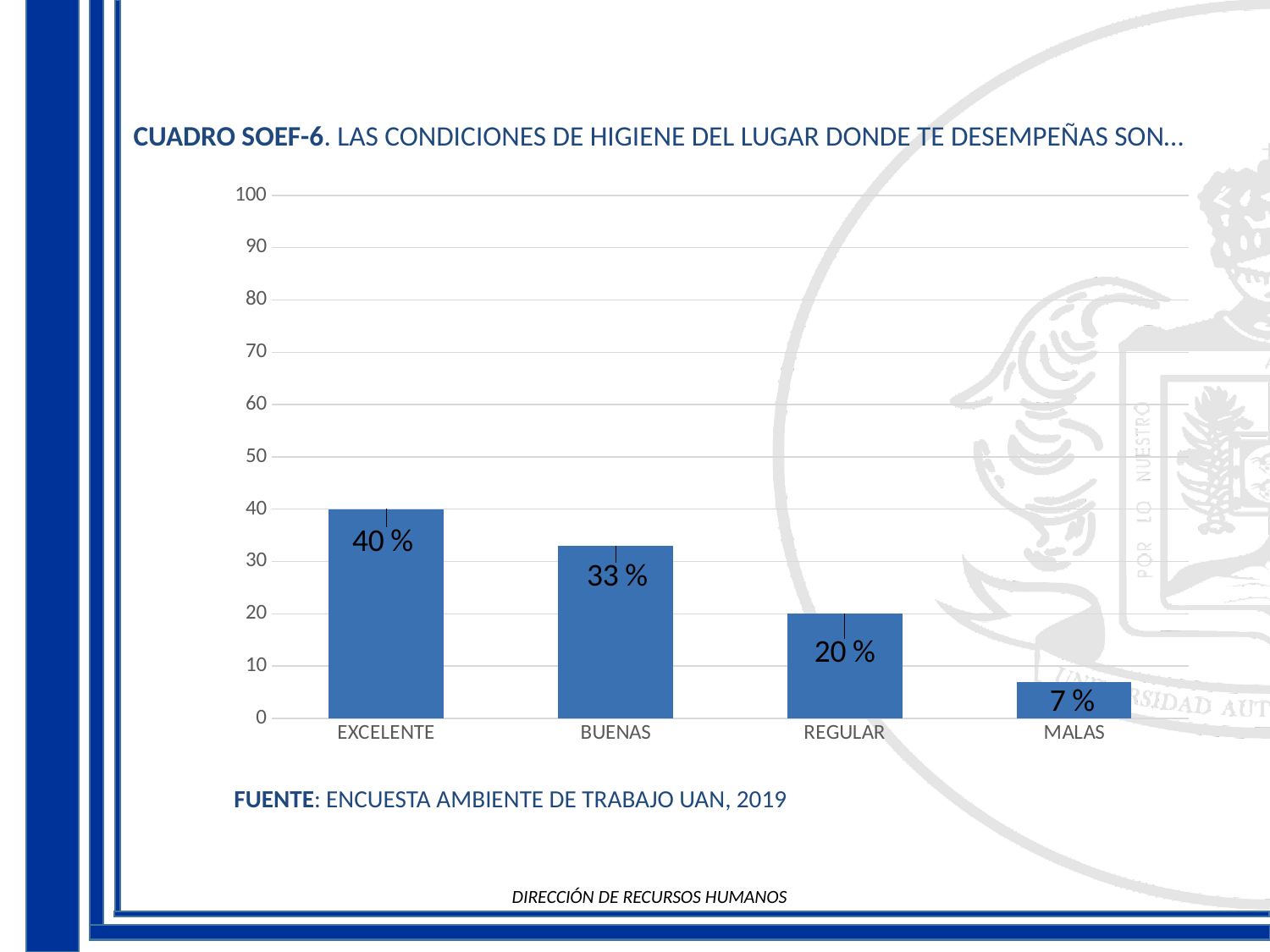
What is the difference between the values for REGULAR and MALAS? 13 % What is the value for BUENAS? 33 % What is the value for MALAS? 7 % How many categories are shown on the x axis? 4 Which category has the lowest value? MALAS Which is larger, the value for BUENAS or the value for REGULAR? BUENAS Do the values rise or fall from left to right along the x axis? fall Which category has the highest value? EXCELENTE What is the value for EXCELENTE? 40 % What is the value for REGULAR? 20 % What is the difference between the values for EXCELENTE and BUENAS? 7 % What kind of chart is shown on the slide? bar chart